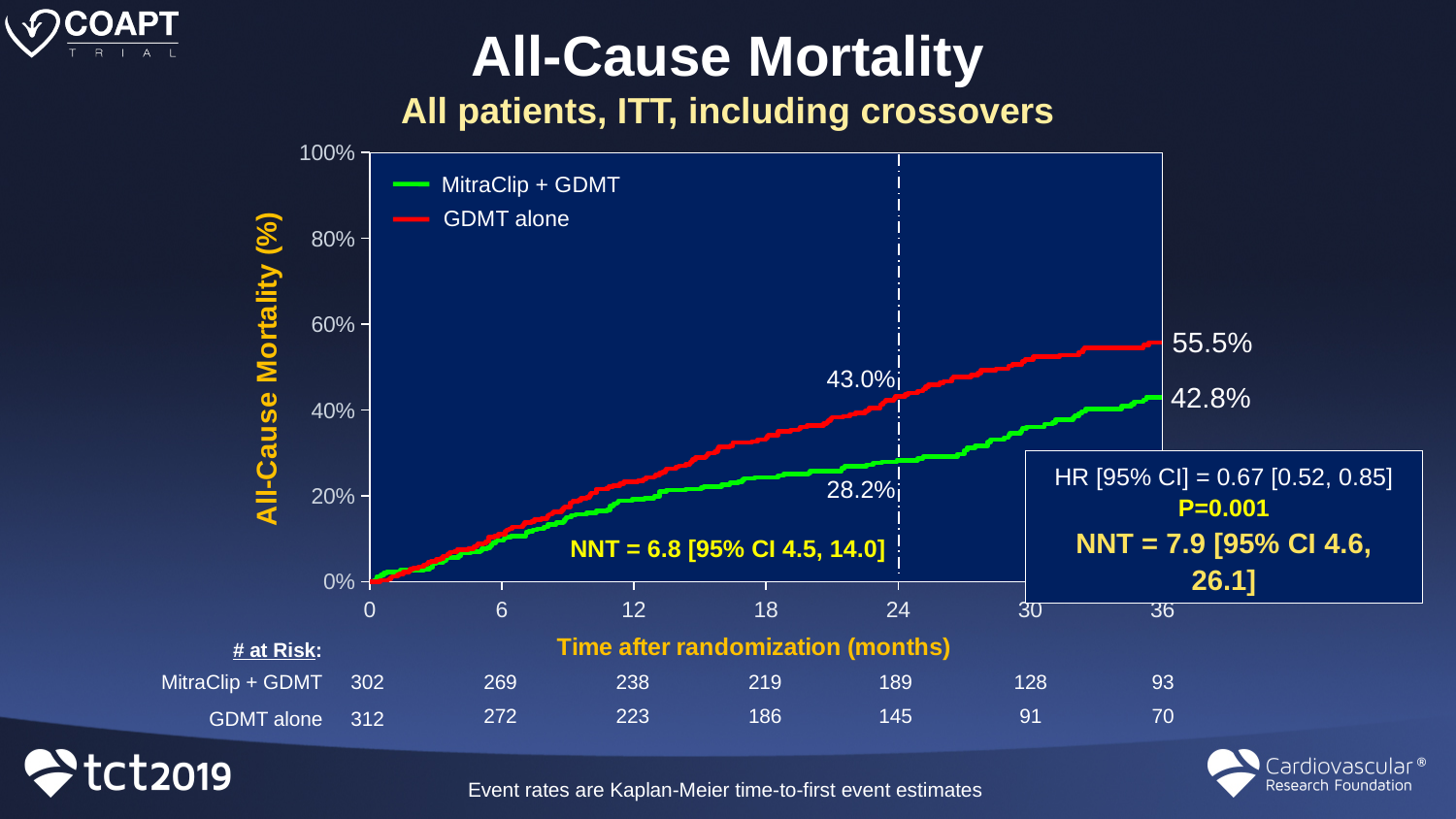
How many series does the legend list? 2 What is the all-cause mortality for MitraClip + GDMT at 24 months? 28.2% What is the all-cause mortality for MitraClip + GDMT at 36 months? 42.8% What is the all-cause mortality for GDMT alone at 36 months? 55.5% What type of chart is shown on the slide? Line chart How many patients were at risk in the MitraClip + GDMT group at 0 months? 302 What is the all-cause mortality for GDMT alone at 24 months? 43.0% Is the all-cause mortality for GDMT alone at 18 months greater or less than 20%? greater Which group has the higher all-cause mortality at 36 months, GDMT alone or MitraClip + GDMT? GDMT alone Do the mortality curves rise or fall over time after randomization? Rise What is the difference in all-cause mortality between GDMT alone and MitraClip + GDMT at 24 months? 14.8% Which colour represents the GDMT alone series? Red